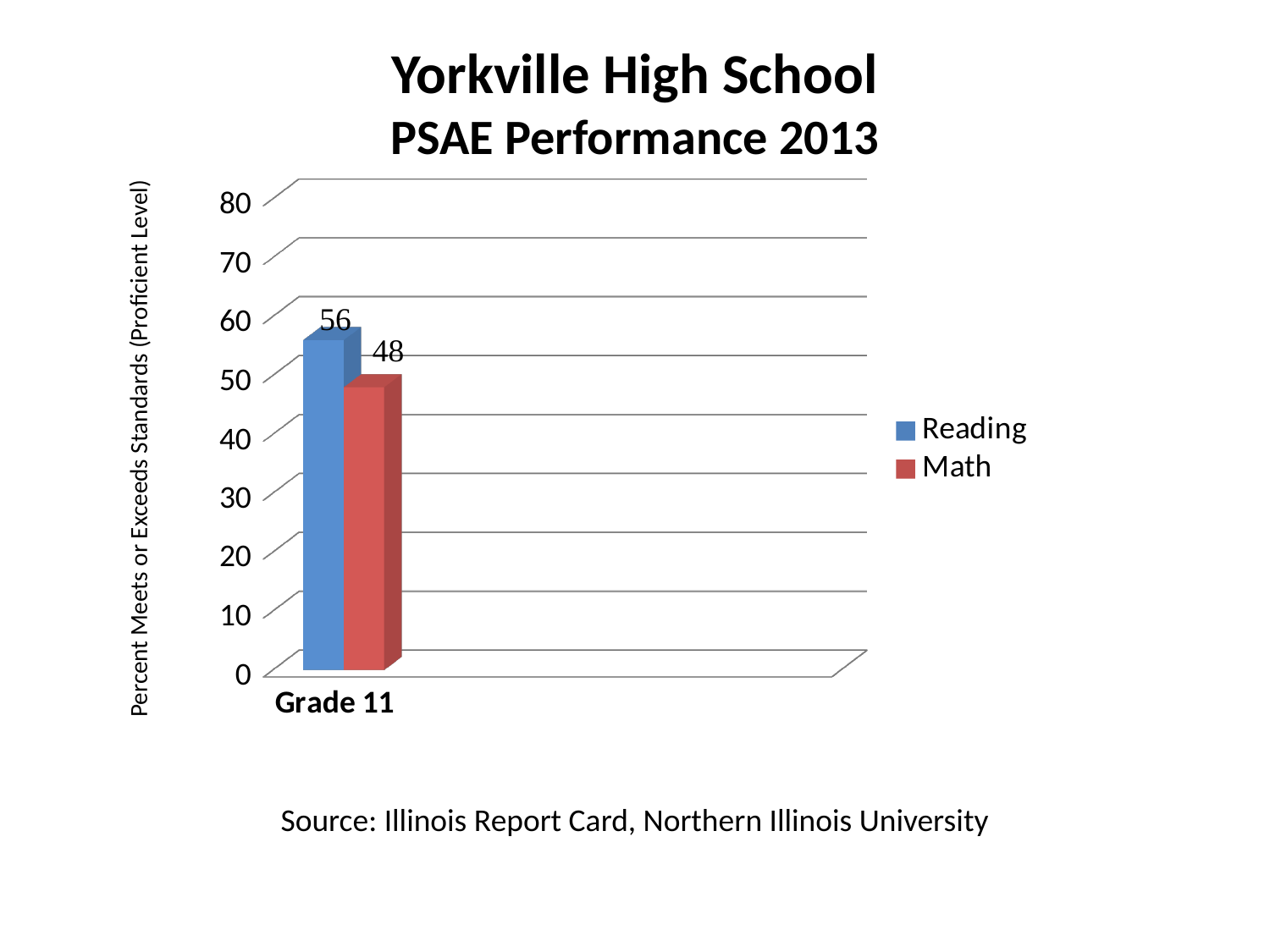
What is the Math value for Grade 11? 48 What kind of chart is shown on the slide? bar chart What is the label of the y axis? Percent Meets or Exceeds Standards (Proficient Level) What is the difference between the Reading and Math values for Grade 11? 8 Which series has the higher value for Grade 11, Reading or Math? Reading Is the Math value for Grade 11 greater or less than 50? less What is the Reading value for Grade 11? 56 Is the Reading value for Grade 11 greater or less than 50? greater Which series is the lowest for Grade 11? Math How many categories are shown on the x axis? 1 How many series does the legend list? 2 What colour represents the Math series? Red